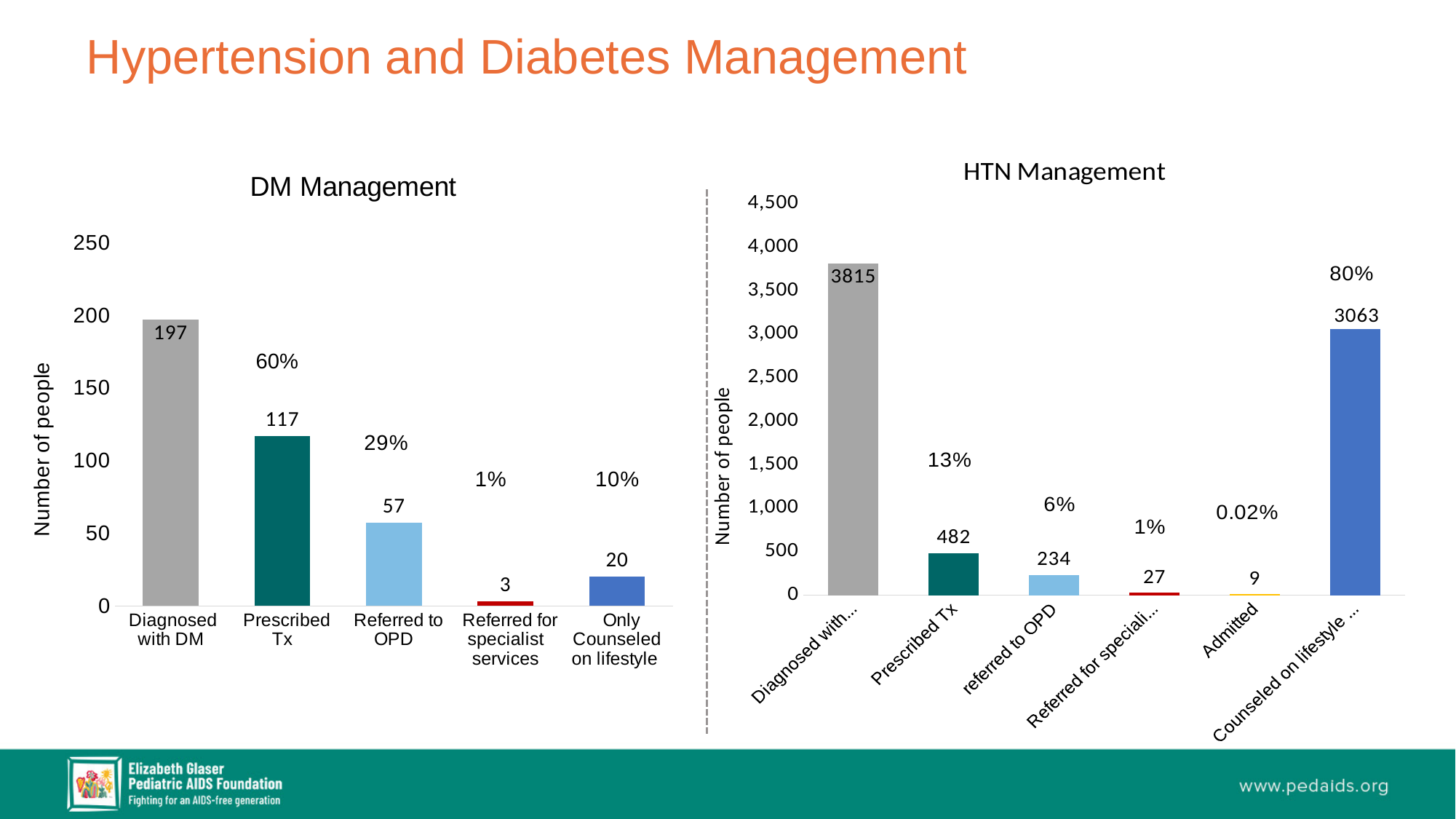
In the HTN Management chart, how many people were Admitted? 9 In the HTN Management chart, what percentage label is shown above the Counseled on lifestyle bar? 80% What type of chart is the HTN Management chart? Bar chart In the DM Management chart, which category has the lowest value? Referred for specialist services In the DM Management chart, how many categories are shown on the x axis? 5 In the DM Management chart, how many people were diagnosed with DM? 197 In the HTN Management chart, what is the value for Prescribed Tx? 482 In the HTN Management chart, which is larger: Prescribed Tx or referred to OPD? Prescribed Tx In the DM Management chart, what is the difference between Diagnosed with DM and Prescribed Tx? 80 In the DM Management chart, what is the value for Prescribed Tx? 117 In the HTN Management chart, which category has the highest value? Diagnosed with... In the DM Management chart, what percentage label is shown above the Referred to OPD bar? 29%